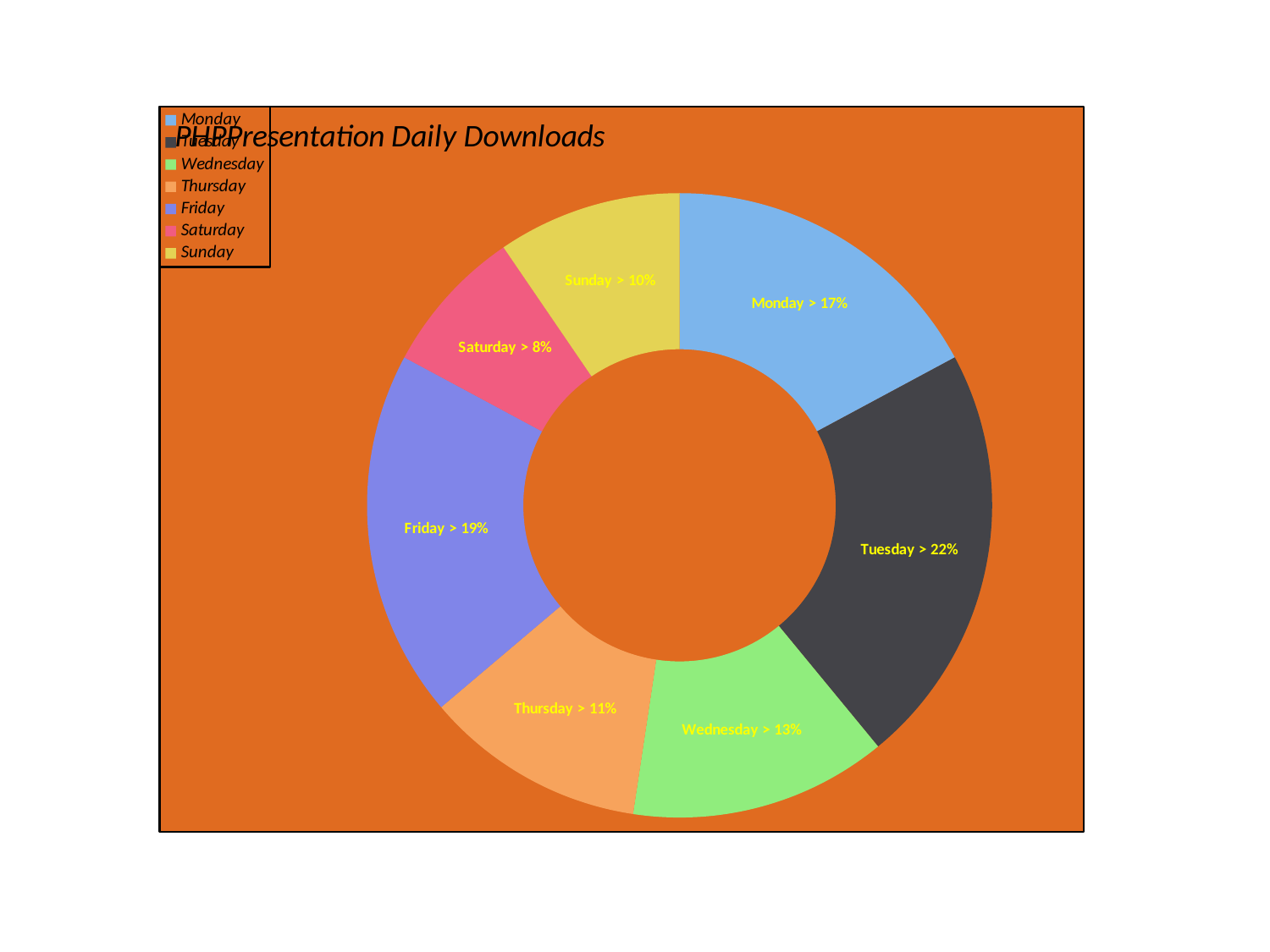
What share of daily downloads does Wednesday account for? 13% Which day has the smallest share of downloads? Saturday What kind of chart is shown on the slide? Doughnut (pie) chart Which has a larger share, Thursday or Sunday? Thursday What share of daily downloads does Friday account for? 19% What colour is the Friday segment? Purple/blue How many days are shown in the chart? 7 What share of daily downloads does Saturday account for? 8% What is the difference in percentage points between Tuesday's and Monday's shares? 5 What is the title of the chart? PHPPresentation Daily Downloads Which day has the largest share of downloads? Tuesday What share of daily downloads does Tuesday account for? 22%